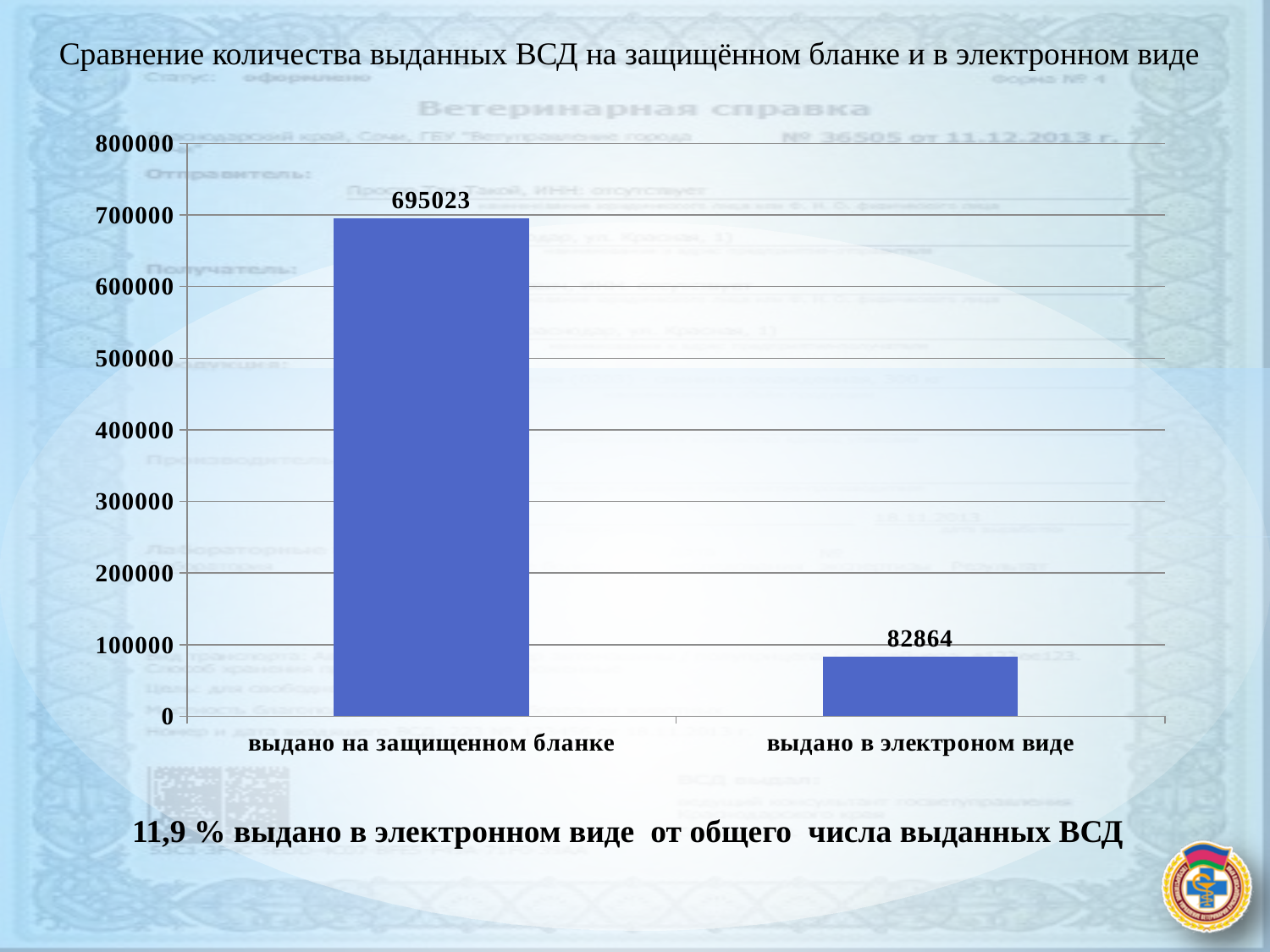
How many categories are shown on the chart? 2 Which is larger: the value for "выдано на защищенном бланке" or the value for "выдано в электроном виде"? выдано на защищенном бланке What is the maximum value shown on the vertical axis? 800000 What is the difference between the value for "выдано на защищенном бланке" and the value for "выдано в электроном виде"? 612159 What is the value for "выдано на защищенном бланке"? 695023 What is the title of the chart on the slide? Сравнение количества выданных ВСД на защищённом бланке и в электронном виде Is the value for "выдано на защищенном бланке" greater or less than 600000? greater What is the value for "выдано в электроном виде"? 82864 Which category has the lowest value? выдано в электроном виде Which category has the highest value? выдано на защищенном бланке Is the value for "выдано в электроном виде" greater or less than 100000? less What kind of chart is shown on the slide? bar chart